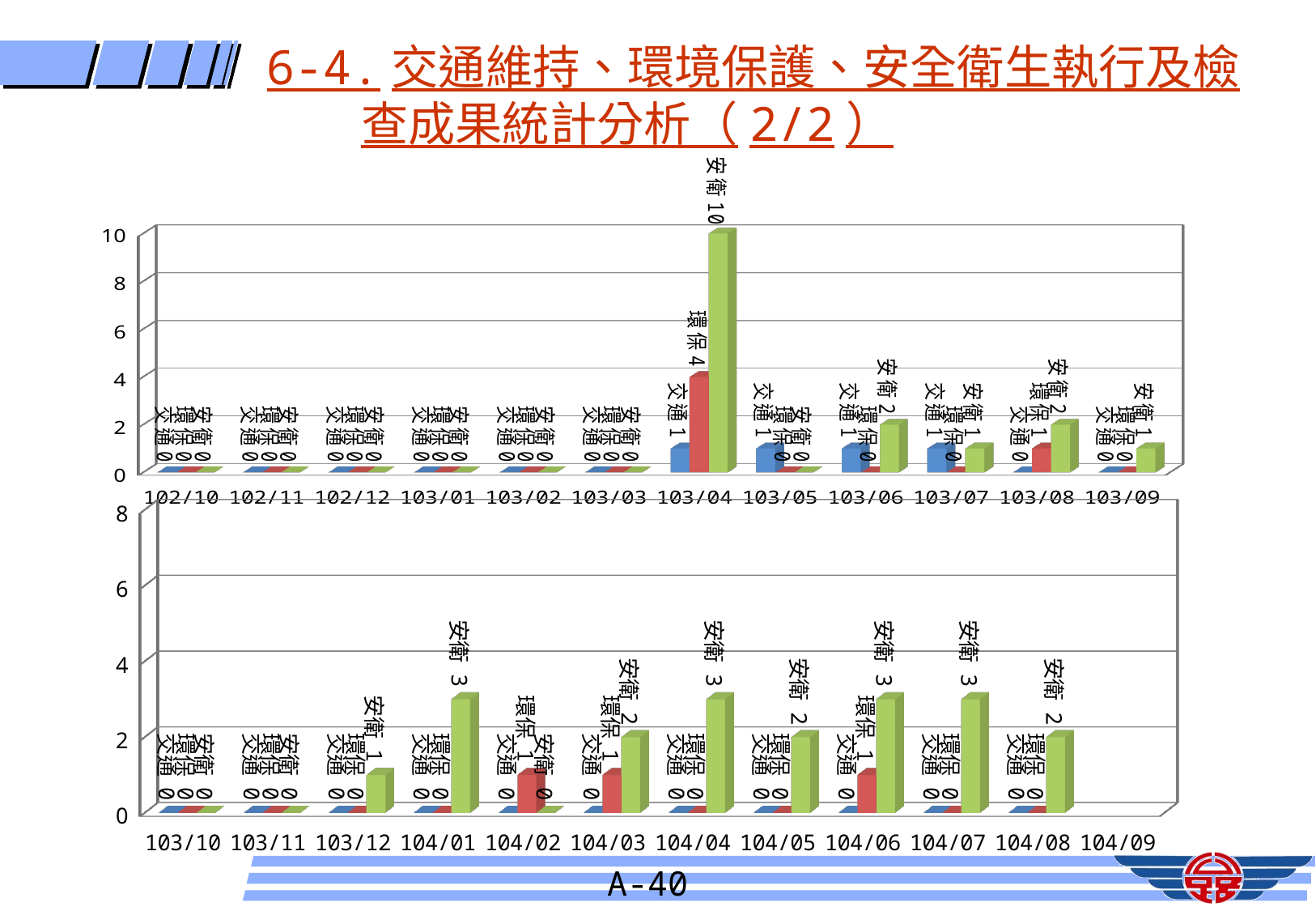
In the top chart, what is the maximum value shown on the vertical axis? 10 In the top chart, what is the difference between the 安衛 value and the 環保 value for 103/04? 6 In the bottom chart, what is the value of 環保 for 104/06? 1 In the top chart, how many months are shown on the x axis? 12 In the top chart, which month has the highest 安衛 value? 103/04 In the bottom chart, what is the value of 安衛 for 104/01? 3 In the bottom chart, what is the total of 交通, 環保 and 安衛 for 104/03? 3 In the top chart, what is the value of 安衛 for 103/06? 2 What kind of chart is the top chart? bar chart In the top chart, what is the value of 安衛 for 103/04? 10 In the bottom chart, which is larger, the 安衛 value for 104/03 or the 安衛 value for 104/04? 104/04 In the top chart, what is the value of 環保 for 103/04? 4